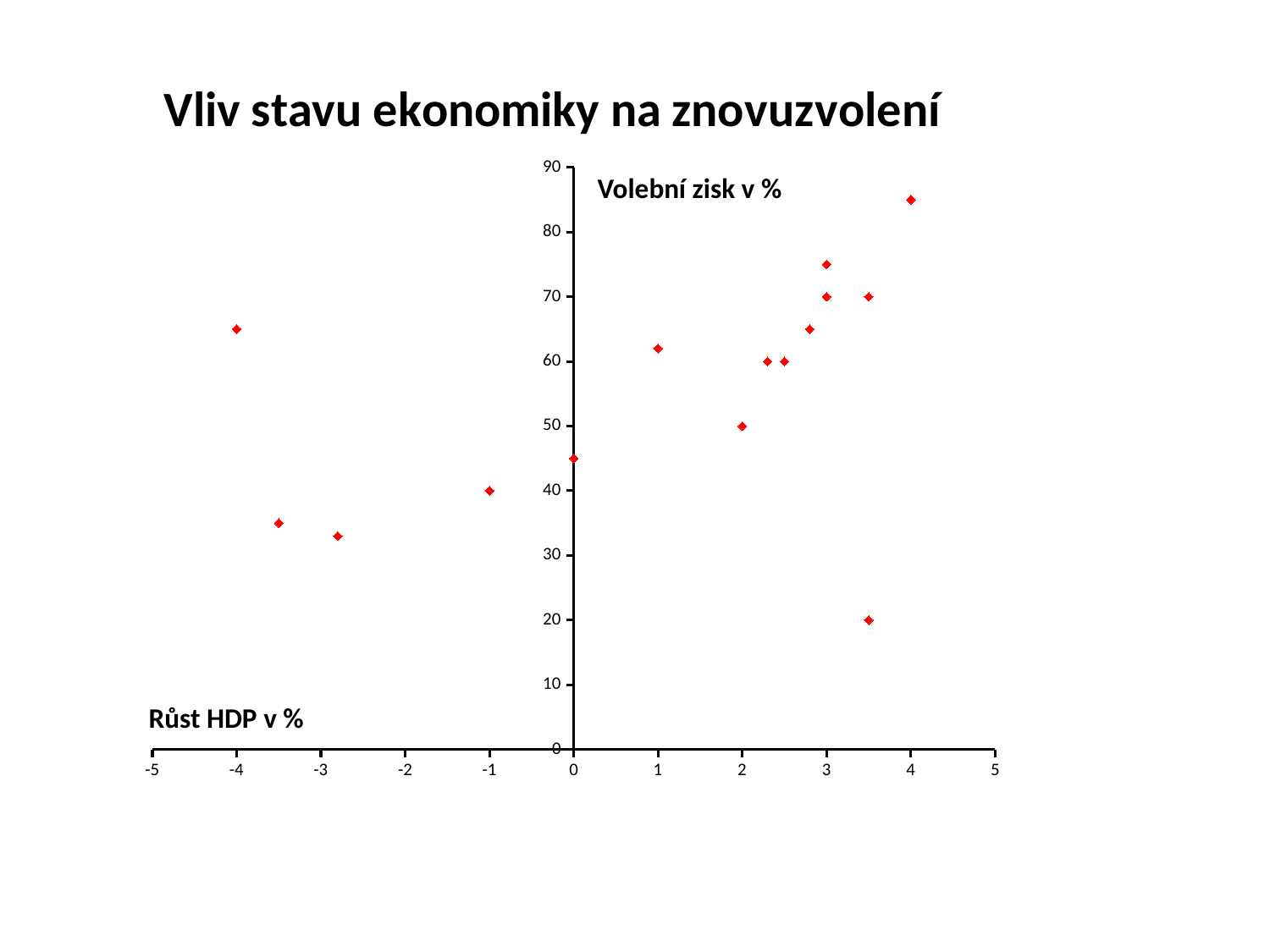
What kind of chart is shown on the slide? scatter chart At which GDP growth value is the point with the highest election gain located? 4 Is the election gain for the point at GDP growth 0 greater or less than 50? less What label is given to the vertical axis of the chart? Volební zisk v % What is the title of the chart? Vliv stavu ekonomiky na znovuzvolení Is the election gain for the point at GDP growth 1 greater or less than 50? greater Which has the larger election gain: the point at GDP growth 4 or the point at GDP growth 1? the point at GDP growth 4 Is the election gain for the point at GDP growth 4 greater or less than 80? greater How many data points are plotted on the chart? 15